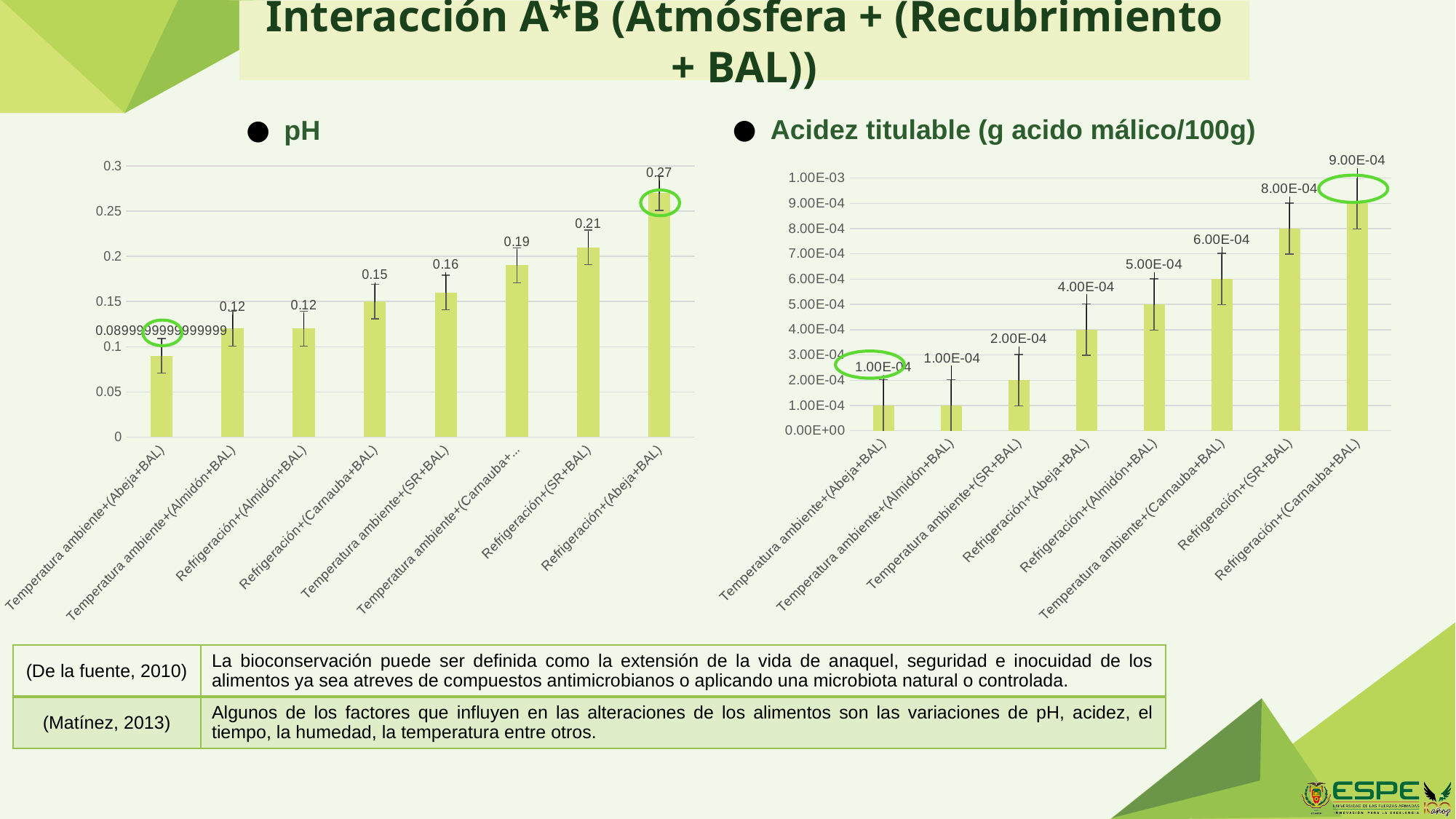
In the Acidez titulable chart, what is the value for Refrigeración+(Abeja+BAL)? 4.00E-04 In the Acidez titulable chart, what is the value for Refrigeración+(Carnauba+BAL)? 9.00E-04 In the pH chart, what is the difference between Refrigeración+(Abeja+BAL) and Temperatura ambiente+(SR+BAL)? 0.11 In the pH chart, what is the value for Refrigeración+(SR+BAL)? 0.21 In the pH chart, which category has the highest value? Refrigeración+(Abeja+BAL) What kind of chart is the Acidez titulable chart? bar chart In the Acidez titulable chart, is the value for Refrigeración+(SR+BAL) greater or less than 7.00E-04? greater In the pH chart, how many categories are plotted? 8 In the Acidez titulable chart, do the values rise or fall from left to right along the x axis? rise In the pH chart, which is larger: Refrigeración+(Carnauba+BAL) or Temperatura ambiente+(SR+BAL)? Temperatura ambiente+(SR+BAL) In the pH chart, what is the value for Refrigeración+(Abeja+BAL)? 0.27 In the Acidez titulable chart, which category has the highest value? Refrigeración+(Carnauba+BAL)